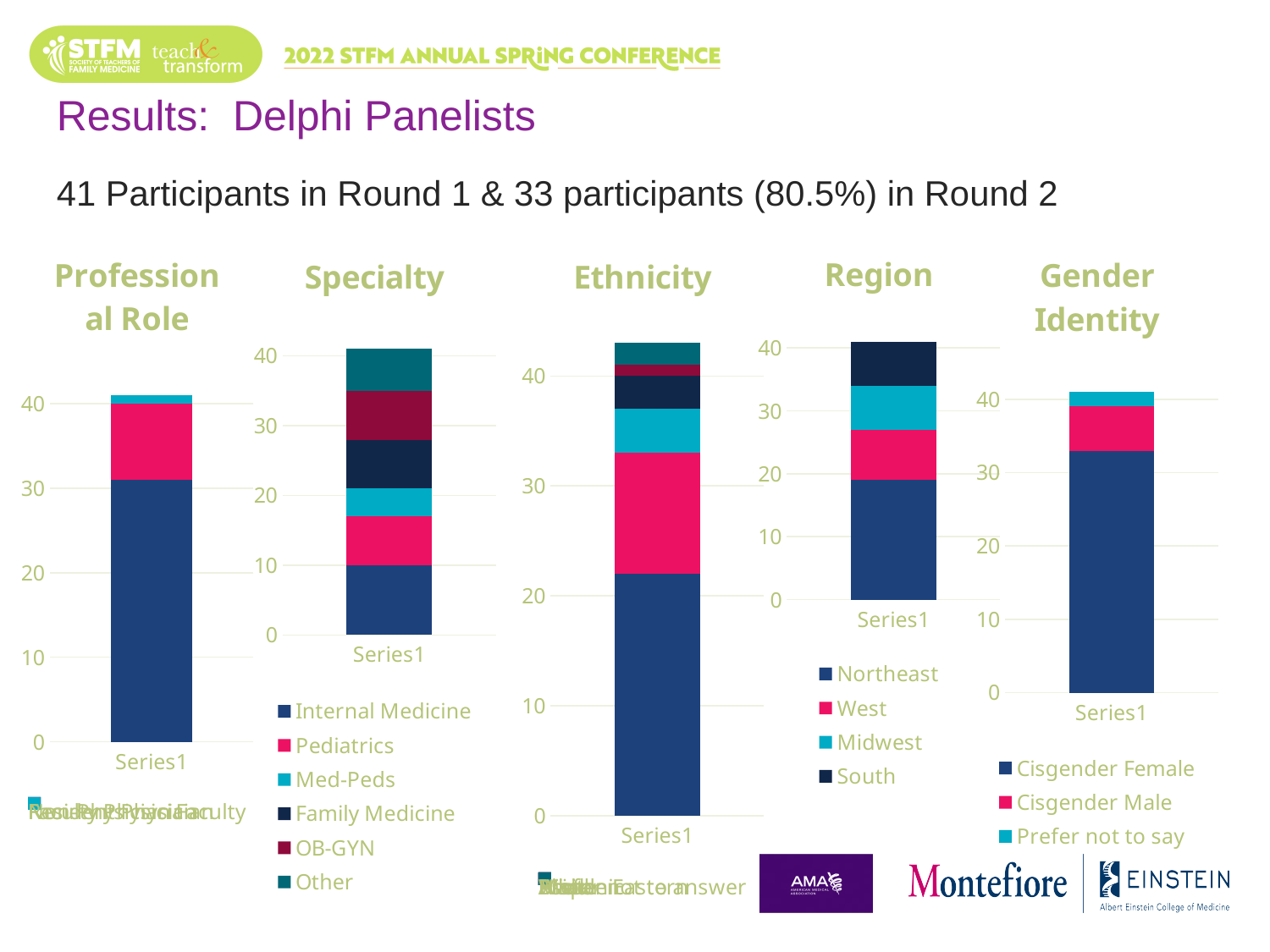
How many series does the legend of the Gender Identity chart list? 3 In the Ethnicity chart, is the total height of the stacked bar greater or less than 40? greater How many series does the legend of the Region chart list? 4 How many series does the legend of the Specialty chart list? 6 In the Specialty chart, which segment is the smallest? Med-Peds In the Gender Identity chart, which segment is the largest? Cisgender Female In the Region chart, which segment is larger, Northeast or West? Northeast In the Region chart, which segment is the largest? Northeast In the Gender Identity chart, is the Cisgender Female segment greater or less than 30? greater What kind of chart is the Specialty chart? stacked bar chart In the Gender Identity chart, which segment is the smallest? Prefer not to say